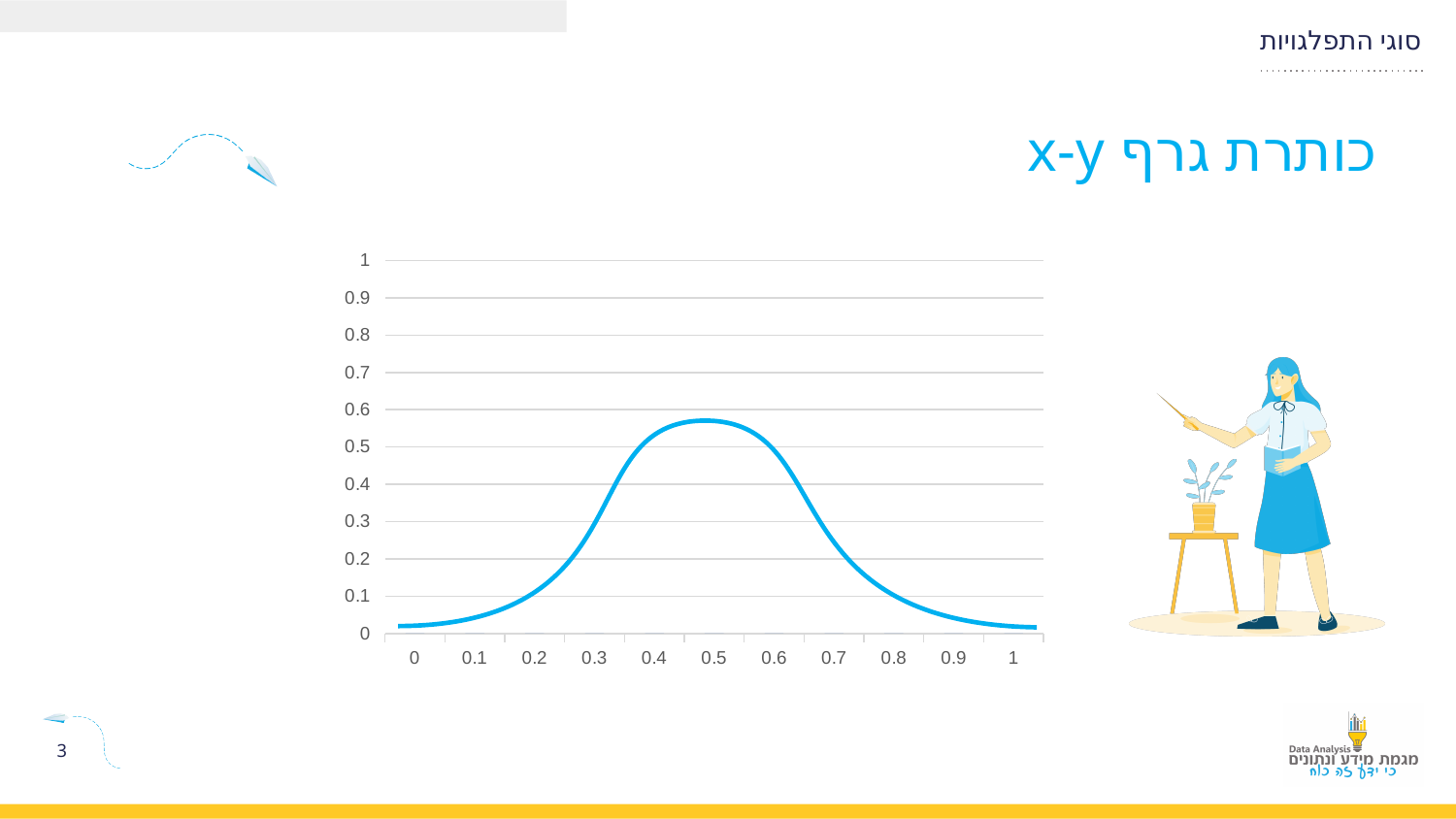
How many tick labels are shown on the x axis? 11 Is the peak value of the curve greater or less than 0.5? greater Does the curve rise or fall as x goes from 0.5 to 1? fall Is the value of the curve at x = 1 greater or less than 0.1? less What is the title of the chart? כותרת גרף x-y Does the curve rise or fall as x goes from 0 to 0.5? rise What kind of chart is shown on the slide? line chart Is the peak value of the curve greater or less than 0.6? less What is the highest value labelled on the y axis? 1